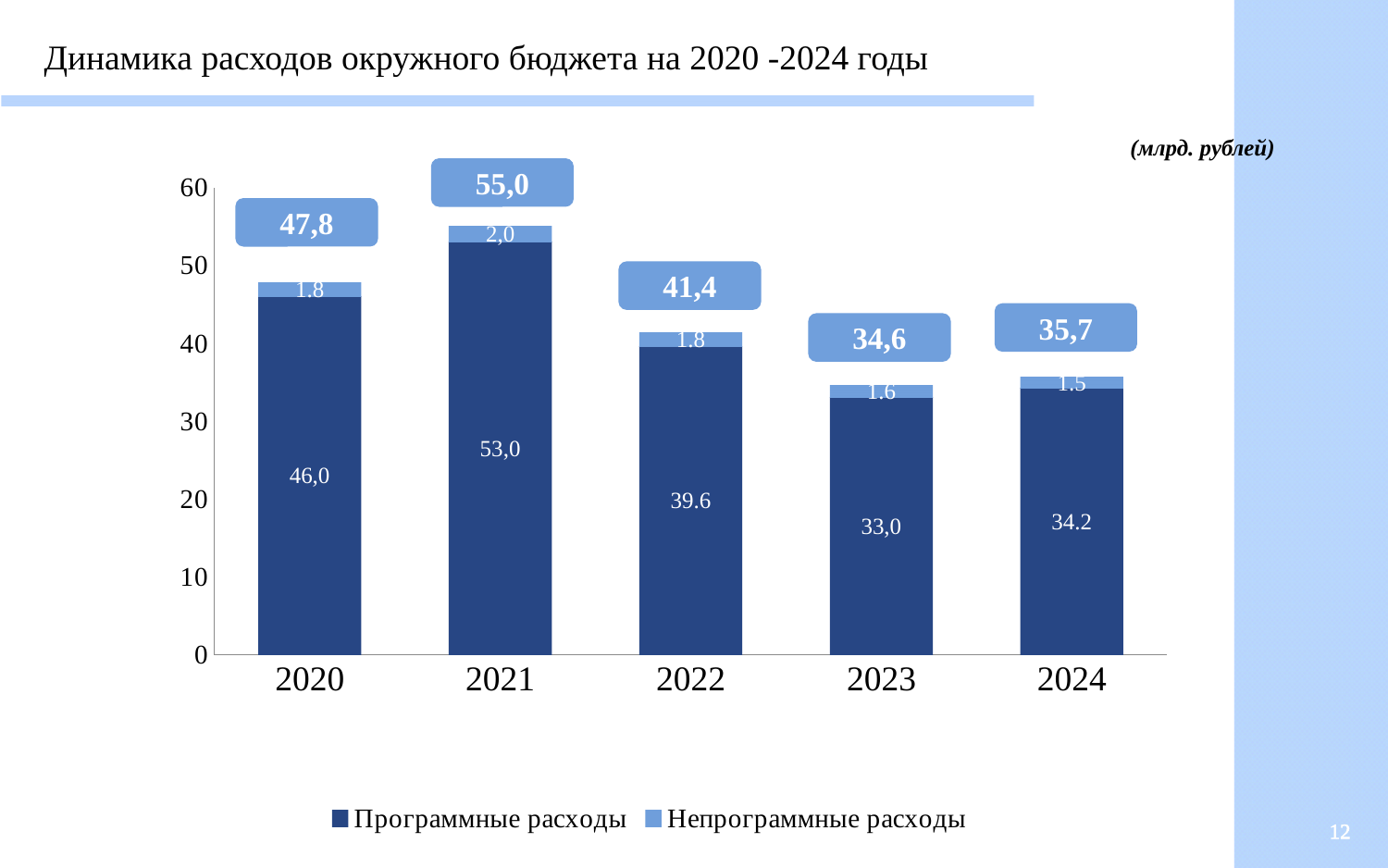
What is the value of Непрограммные расходы for 2023? 1.6 How many series does the legend list? 2 Which year has the highest total expenditure? 2021 Which is larger: Программные расходы in 2024 or in 2023? 2024 Is the total for 2023 greater or less than 40? less What is the difference between the total for 2021 and the total for 2020? 7,2 What is the value of Программные расходы for 2021? 53,0 What unit is indicated for the values on the chart? млрд. рублей How many years are shown on the x axis? 5 What type of chart is shown on the slide? Stacked bar chart Which year has the lowest value for Программные расходы? 2023 What is the total expenditure shown for 2022? 41,4